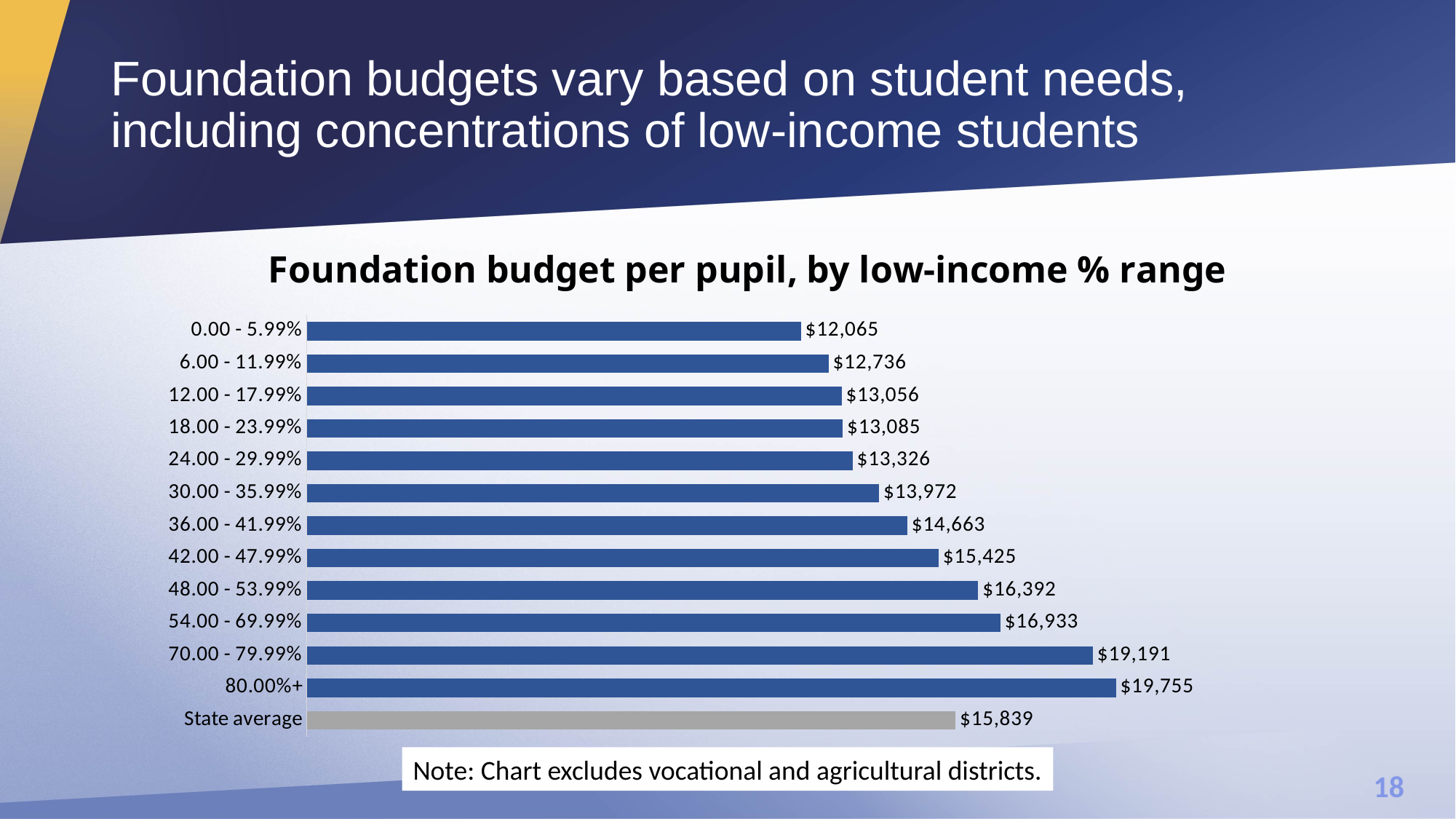
Which low-income % range has the highest foundation budget per pupil? 80.00%+ How many bars are shown on the chart, including the state average? 13 What type of chart is shown on the slide? Bar chart Do the foundation budget per pupil values rise or fall as the low-income % range increases from 0.00 - 5.99% to 80.00%+? Rise Which low-income % range has the lowest foundation budget per pupil? 0.00 - 5.99% What is the foundation budget per pupil for the 42.00 - 47.99% range? $15,425 Which is larger: the foundation budget per pupil for the 48.00 - 53.99% range or the state average? 48.00 - 53.99% What is the state average foundation budget per pupil shown on the chart? $15,839 What is the foundation budget per pupil for the 80.00%+ low-income range? $19,755 What is the difference between the foundation budget per pupil for the 70.00 - 79.99% range and the state average? $3,352 What is the difference between the foundation budget per pupil for the 80.00%+ range and the 0.00 - 5.99% range? $7,690 What is the foundation budget per pupil for the 0.00 - 5.99% low-income range? $12,065